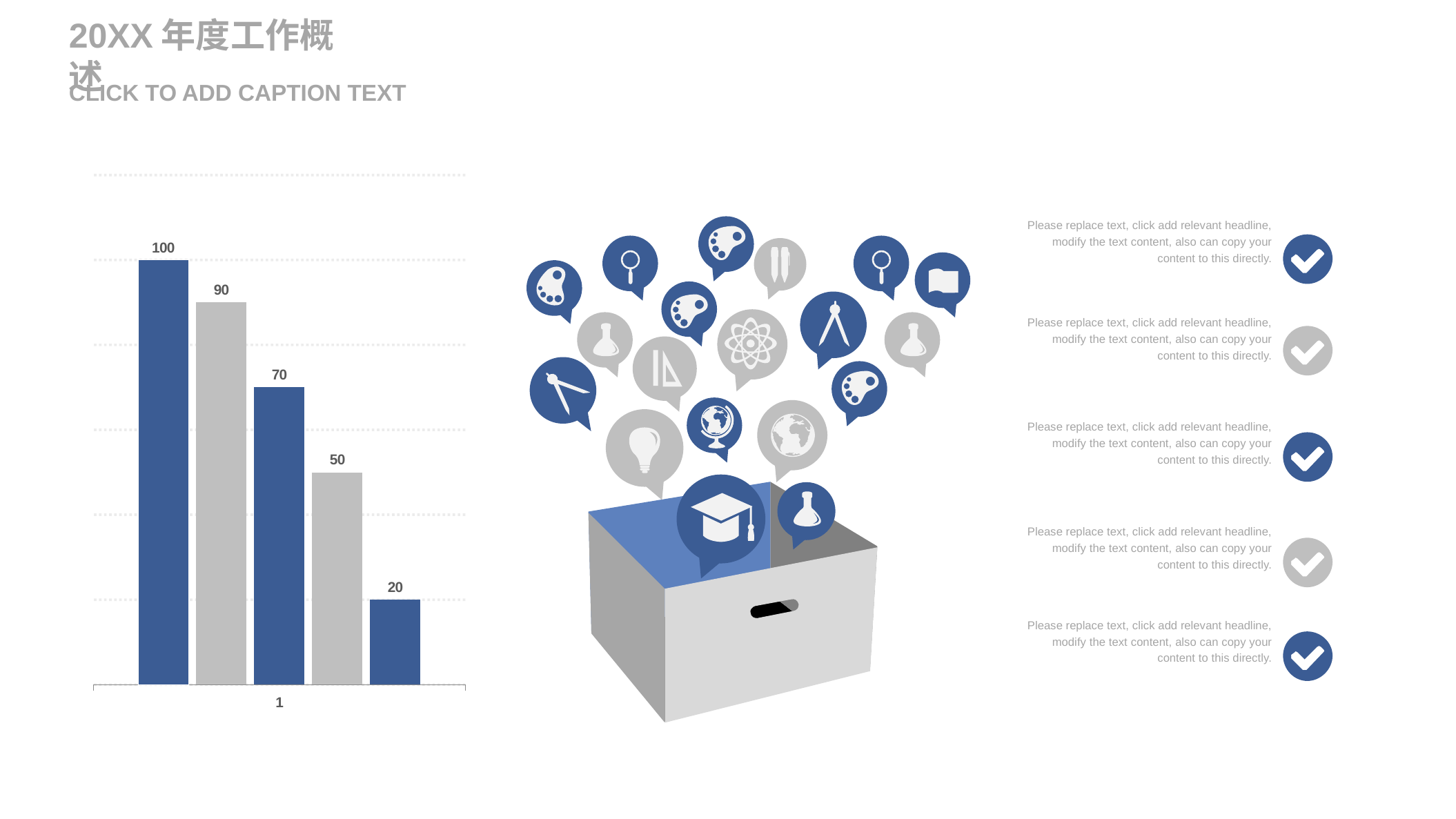
How many bars are plotted in the bar chart? 5 What is the value of the fourth bar from the left in the chart? 50 What kind of chart is shown on the left of the slide? bar chart What is the value of the second bar from the left in the chart? 90 Which is larger, the first bar or the last bar in the chart? the first bar What is the value of the middle (third) bar in the chart? 70 What label appears on the x axis beneath the bars? 1 What is the value shown on the tallest bar in the chart? 100 What is the value shown on the shortest bar in the chart? 20 Do the bar values rise or fall from left to right across the chart? fall What is the difference between the tallest bar (100) and the shortest bar (20)? 80 What is the difference between the second bar (90) and the fourth bar (50)? 40